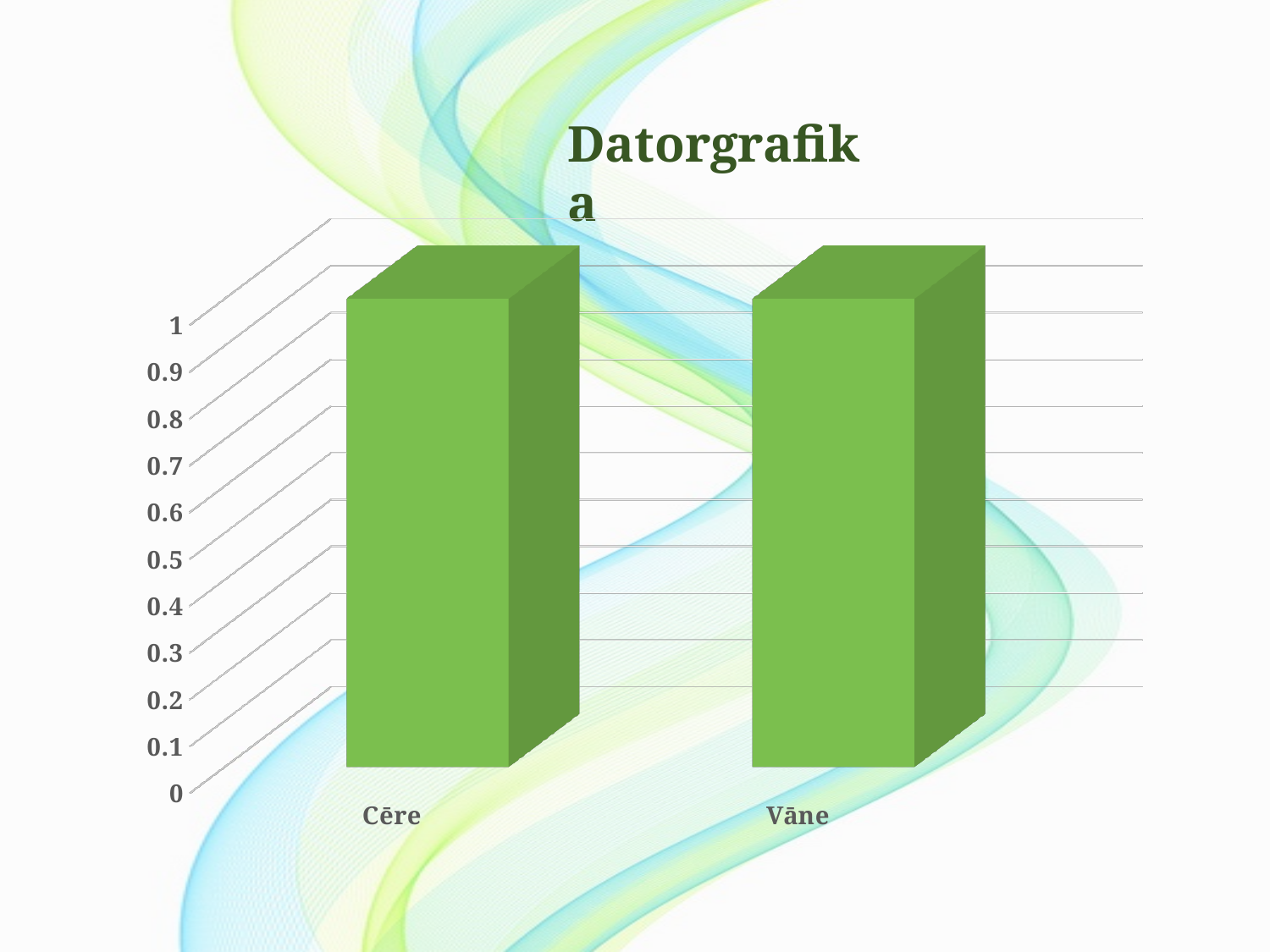
Is the value for Cēre greater or less than 0.8? greater What is the lowest value shown on the y axis of the chart? 0 What is the title of the chart? Datorgrafika Is the value for Vāne greater or less than 0.8? greater What kind of chart is shown on the slide? bar chart What are the two category labels on the x axis of the chart? Cēre and Vāne Is the value for Vāne greater or less than 0.5? greater What is the highest value shown on the y axis of the chart? 1 How many categories are shown on the x axis of the chart? 2